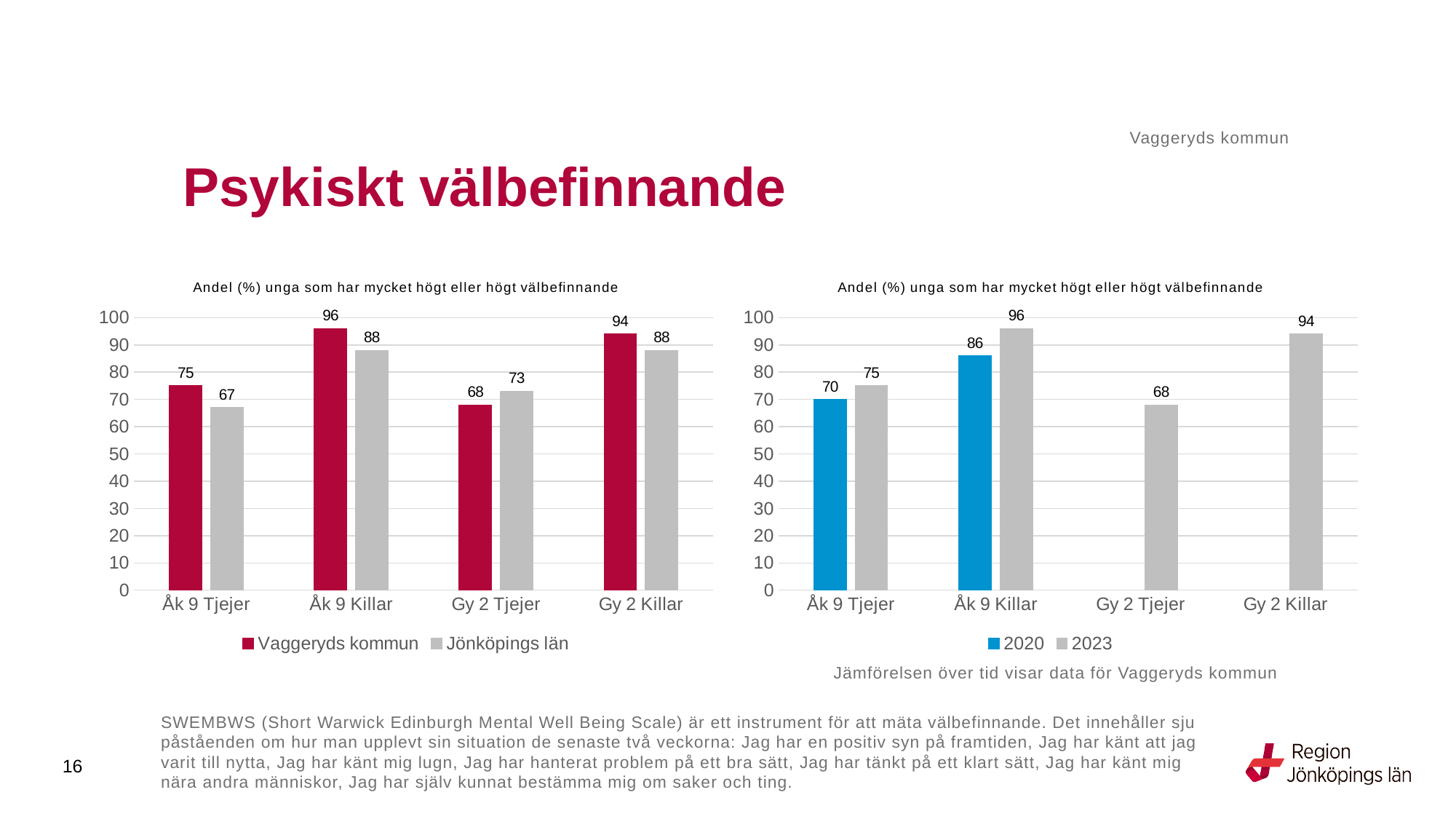
In the left chart, which is larger for Gy 2 Tjejer: Vaggeryds kommun or Jönköpings län? Jönköpings län In the right chart, how many categories are shown on the x axis? 4 In the left chart, which category has the lowest value for Vaggeryds kommun? Gy 2 Tjejer What kind of chart is the right chart? Bar chart In the left chart, what is the value for Jönköpings län for Gy 2 Tjejer? 73 In the right chart, what is the difference between 2023 and 2020 for Åk 9 Killar? 10 In the right chart, what is the value for 2020 for Åk 9 Killar? 86 In the left chart, what is the value for Vaggeryds kommun for Åk 9 Killar? 96 In the right chart, what is the value for 2023 for Gy 2 Killar? 94 In the left chart, how many series does the legend list? 2 In the left chart, what is the difference between Vaggeryds kommun and Jönköpings län for Åk 9 Tjejer? 8 In the right chart, which category has the highest value for 2023? Åk 9 Killar